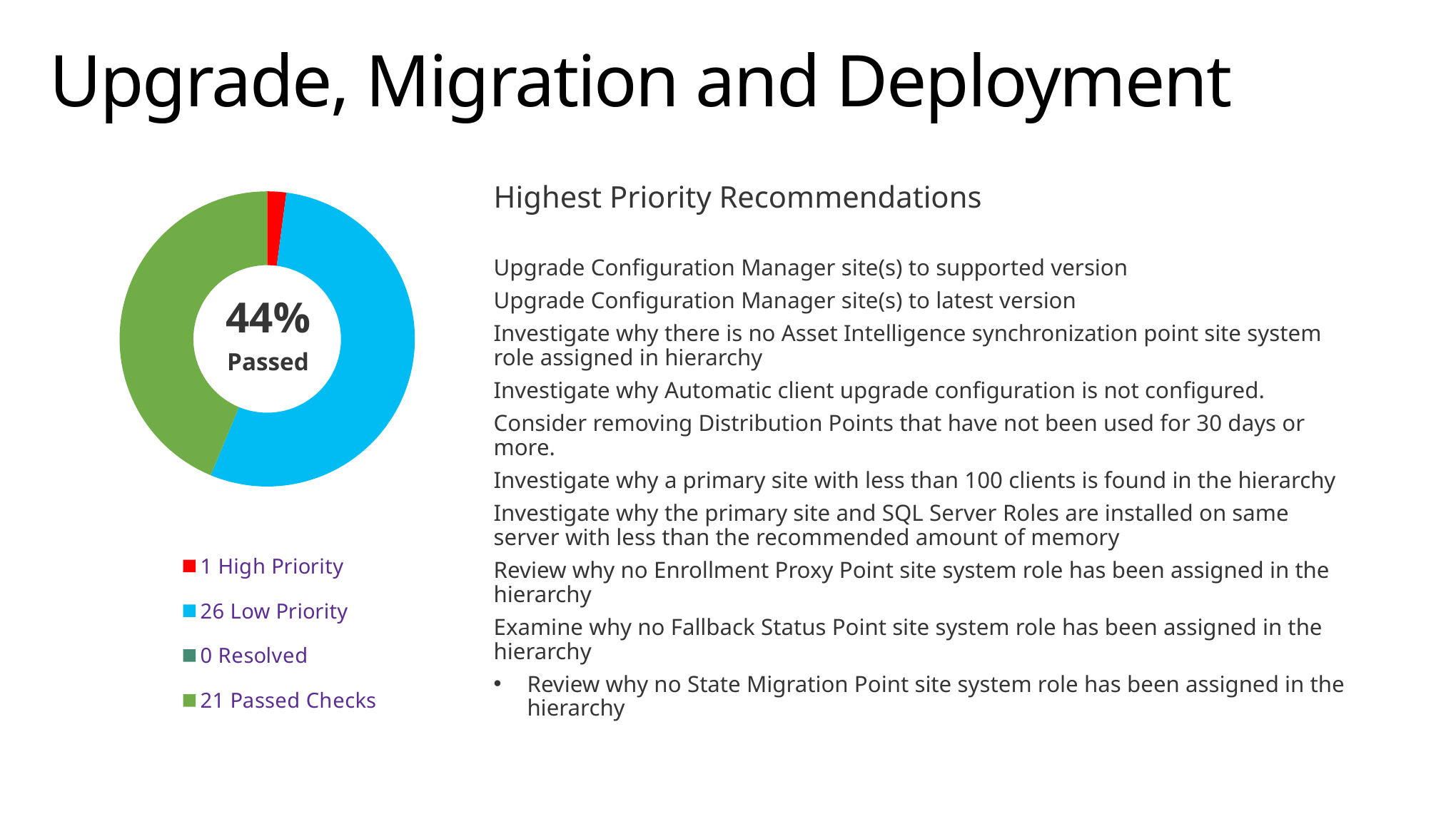
What kind of chart is shown on the slide? Donut (pie) chart Which category has the smallest count in the chart? Resolved How many categories does the chart's legend list? 4 Which is larger: the number of Passed Checks or the number of High Priority items? Passed Checks What is the difference between the number of Low Priority items and the number of Passed Checks? 5 Which category has the largest count in the chart? Low Priority How many Passed Checks does the chart's legend show? 21 How many High Priority items does the chart's legend show? 1 What colour represents Passed Checks in the chart? Green How many Low Priority items does the chart's legend show? 26 How many Resolved items does the chart's legend show? 0 What percentage of checks passed, according to the centre of the donut chart? 44%